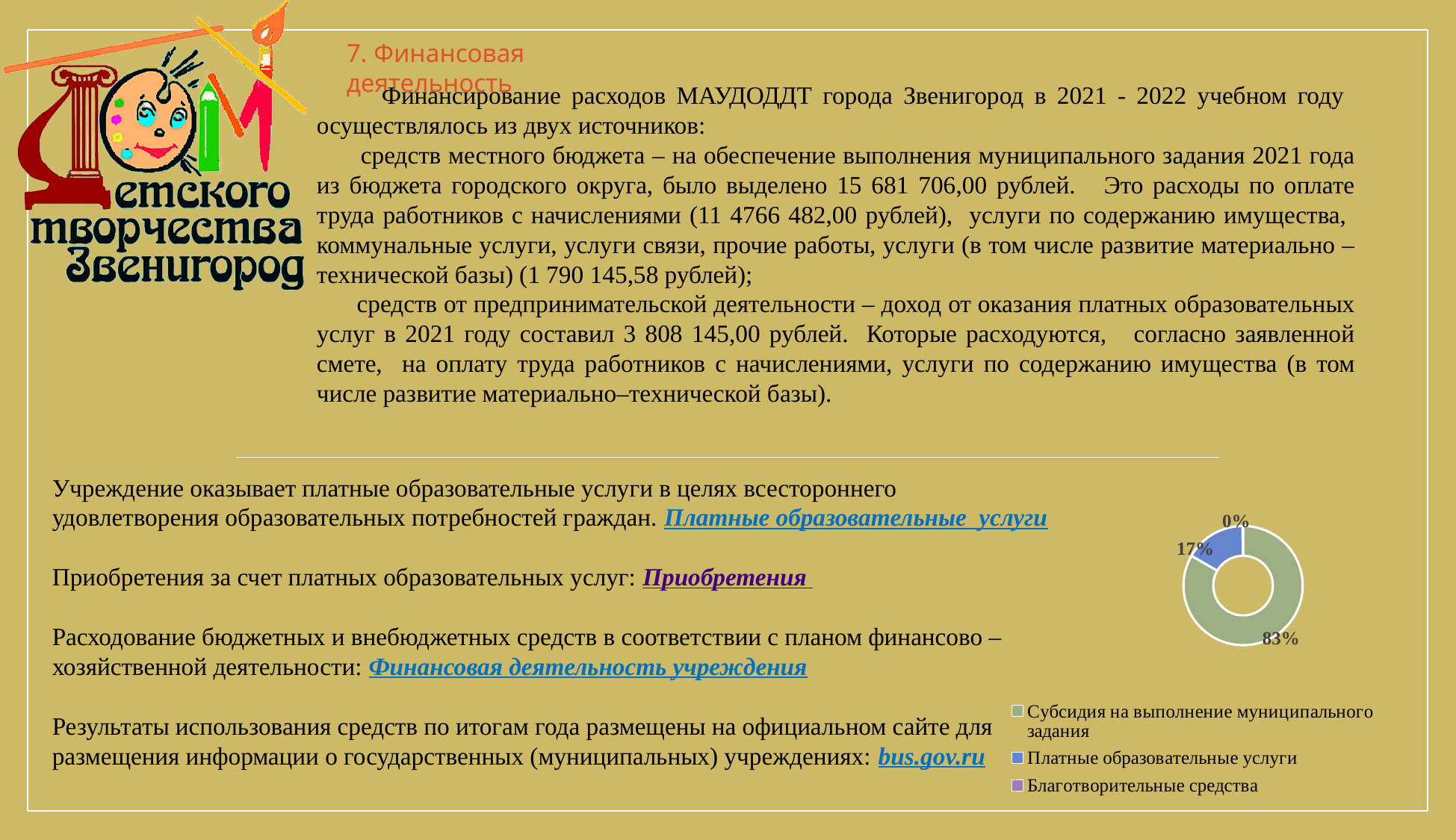
How many categories are shown in the chart? 3 Which category has the largest share in the chart? Субсидия на выполнение муниципального задания Which is larger in the chart: the share of 'Платные образовательные услуги' or the share of 'Благотворительные средства'? Платные образовательные услуги What share of the chart does 'Платные образовательные услуги' take? 17% What colour is the slice for 'Платные образовательные услуги' in the chart? blue What share of the chart does 'Субсидия на выполнение муниципального задания' take? 83% Which category has the smallest share in the chart? Благотворительные средства What colour is the slice for 'Субсидия на выполнение муниципального задания' in the chart? green What share of the chart does 'Благотворительные средства' take? 0% How many entries does the chart legend list? 3 What is the difference in percentage points between the shares of 'Субсидия на выполнение муниципального задания' and 'Платные образовательные услуги'? 66 What kind of chart is shown on the slide? doughnut chart